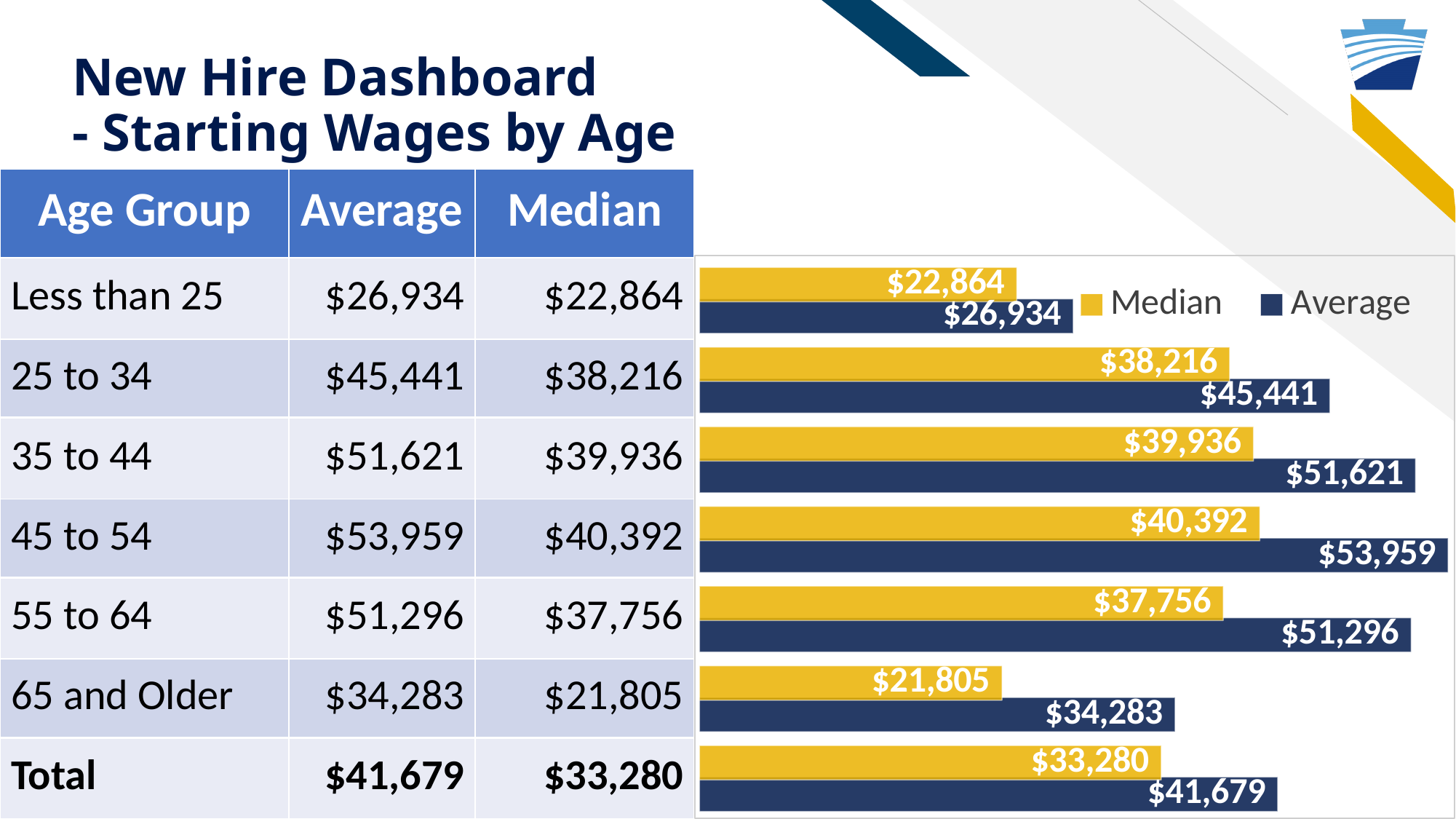
What kind of chart is shown on the slide? bar chart What is the Median starting wage for the 35 to 44 age group in the chart? $39,936 What is the difference between the Average and Median starting wages for the 25 to 34 age group? $7,225 Which age group has the highest Average starting wage in the chart? 45 to 54 What is the Median starting wage shown for the Total bar in the chart? $33,280 What is the Average starting wage for the 65 and Older age group in the chart? $34,283 How many series does the chart's legend list? 2 Which age group has the lowest Median starting wage in the chart? 65 and Older Which colour represents the Median series in the chart? yellow Which is larger in the chart: the Average wage for 55 to 64 or the Average wage for 35 to 44? 35 to 44 How many pairs of bars (categories) are plotted in the chart? 7 What is the difference between the Average starting wage for 45 to 54 and for Less than 25? $27,025